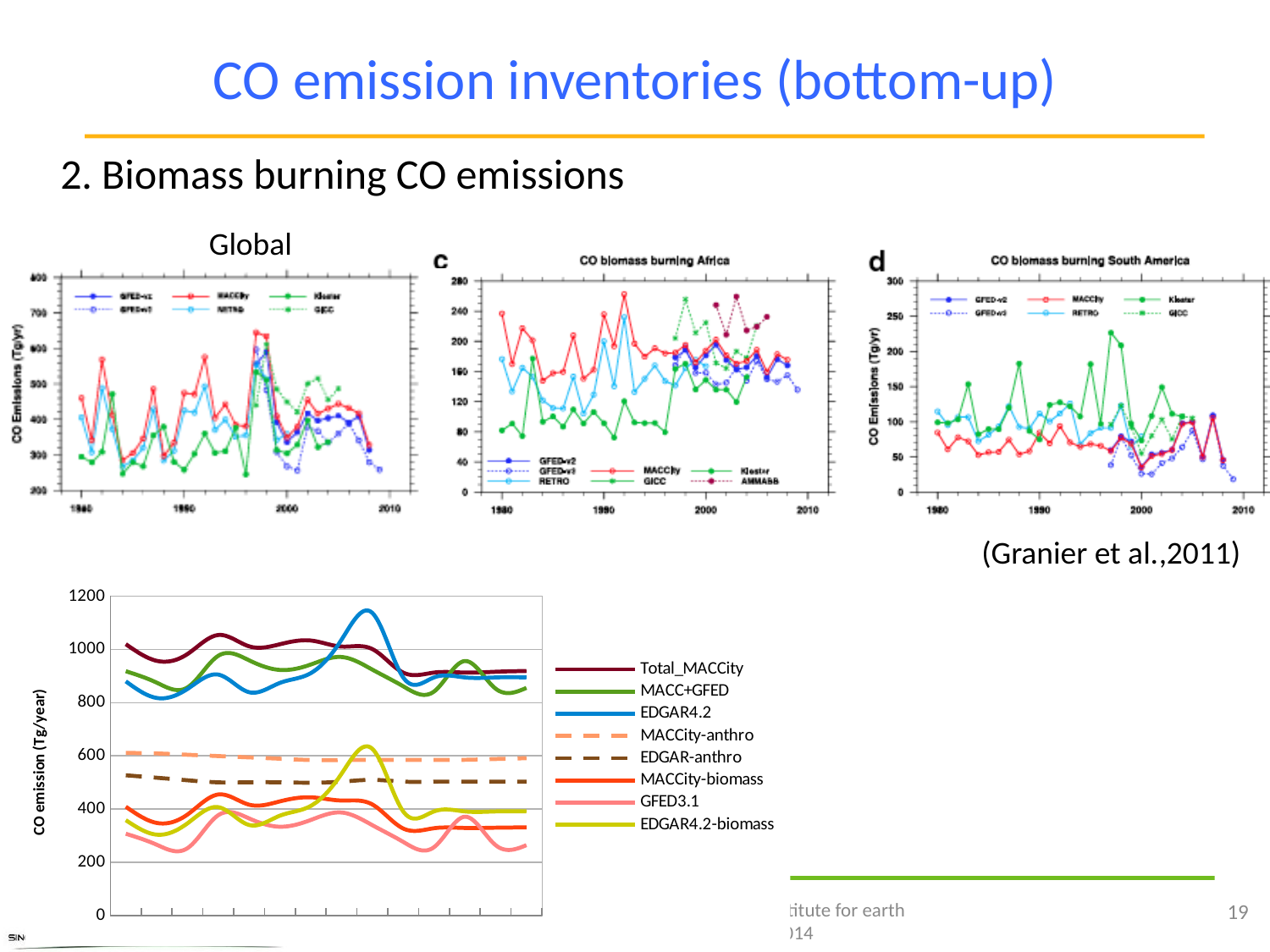
In the bottom-left chart, which series drops to the lowest value? GFED3.1 In the bottom-left chart, is the peak value of EDGAR4.2 greater or less than 1000? greater How many series does the legend of the 'CO biomass burning Africa' chart list? 7 In the bottom-left chart, which two series are drawn with dashed lines? MACCity-anthro and EDGAR-anthro What is the title of the chart labelled 'c' at the top of the slide? CO biomass burning Africa What kind of chart is the bottom-left chart with the y-axis labelled 'CO emission (Tg/year)'? line chart In the 'CO biomass burning South America' chart, is the peak value of the Kloster series greater or less than 200? greater In the bottom-left chart, which series is higher at the left end of the x axis, Total_MACCity or MACC+GFED? Total_MACCity How many series does the legend of the bottom-left chart list? 8 In the bottom-left chart, is the lowest value of GFED3.1 greater or less than 400? less In the bottom-left chart, which series reaches the highest peak value? EDGAR4.2